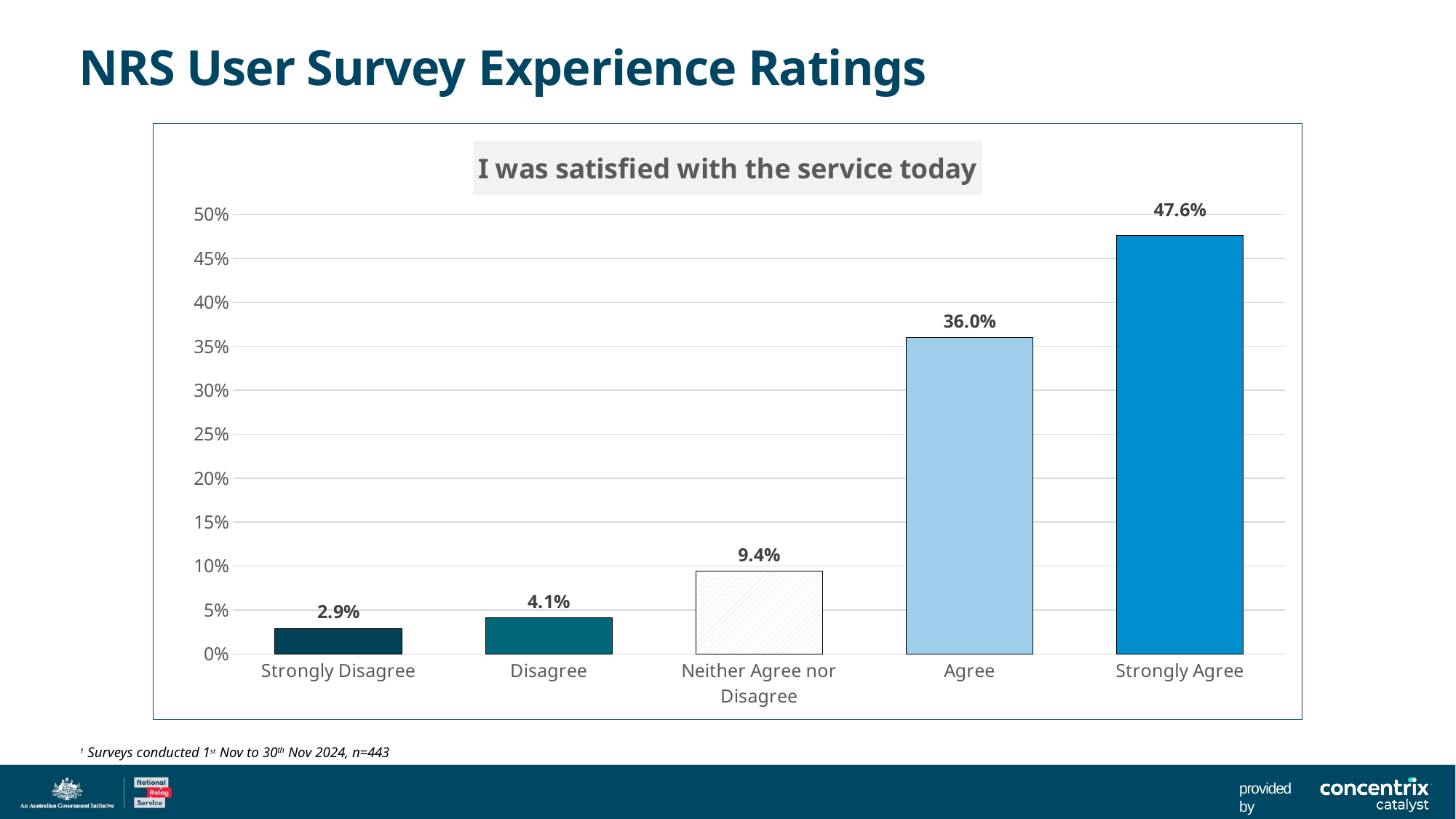
What is the value for Neither Agree nor Disagree? 9.4% What is the difference between the Strongly Agree and Agree values? 11.6% Is the value for Agree greater or less than 40%? less What percentage of respondents answered Strongly Agree? 47.6% What kind of chart is shown on the slide? bar chart What percentage of respondents answered Disagree? 4.1% Which response category has the lowest value? Strongly Disagree What is the title of the chart? I was satisfied with the service today What is the difference between the Disagree and Strongly Disagree values? 1.2% Which response category has the highest value? Strongly Agree How many response categories are shown on the x axis? 5 Which is larger, the value for Agree or the value for Neither Agree nor Disagree? Agree